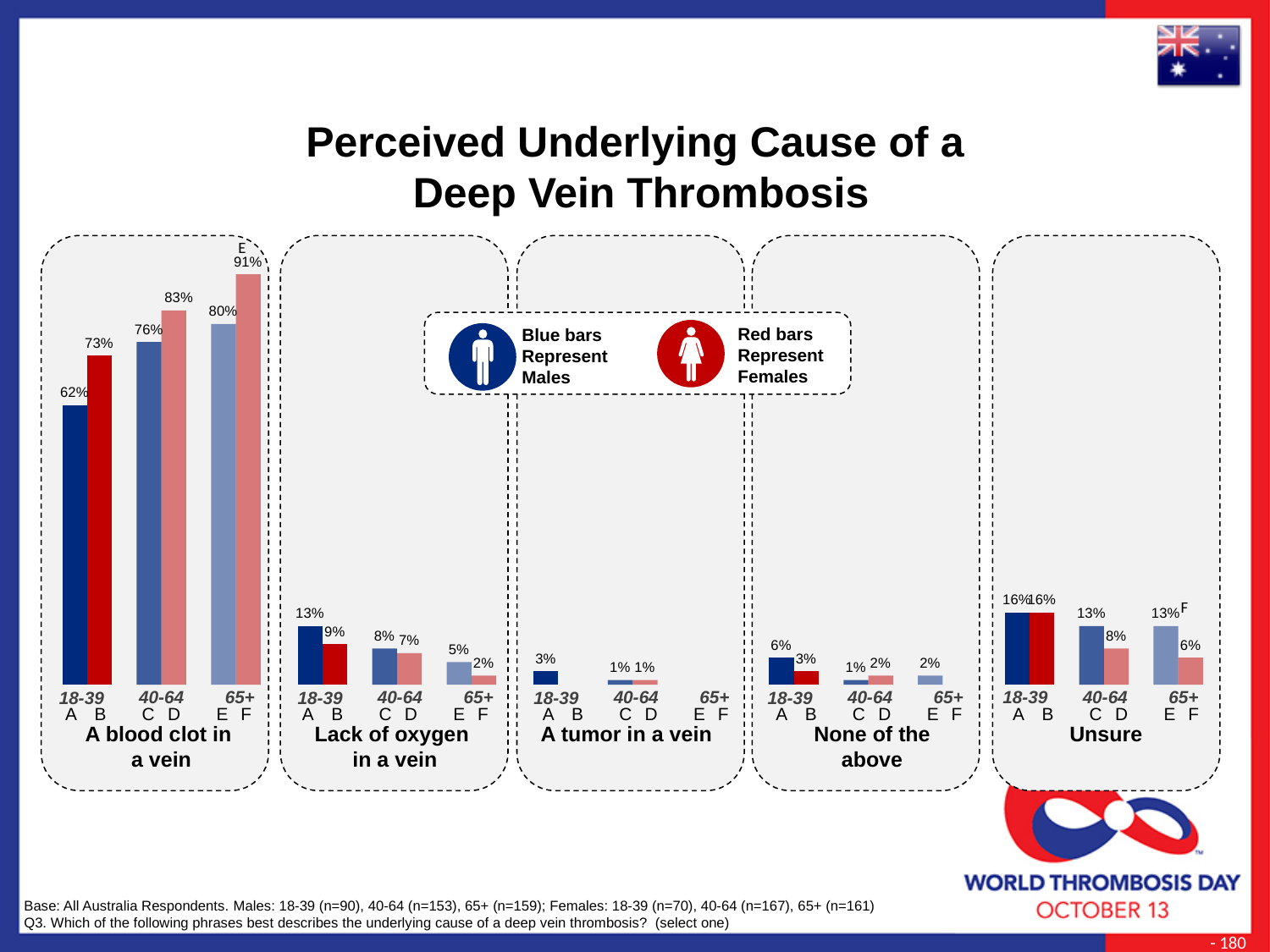
In the 'Lack of oxygen in a vein' panel, which age group has the highest male value? 18-39 In the 'A tumor in a vein' panel, what percentage of males aged 18-39 chose this cause? 3% In the 'A blood clot in a vein' panel, do the female values rise or fall as age group increases from 18-39 to 65+? Rise In the 'A blood clot in a vein' panel, what percentage of males aged 18-39 chose this cause? 62% In the 'A blood clot in a vein' panel, what is the difference between the female and male values for the 40-64 age group? 7% In the 'Unsure' panel, what percentage of females aged 40-64 were unsure? 8% In the 'Unsure' panel, what is the difference between the male and female values for the 65+ age group? 7% What type of chart is used on this slide? Bar chart According to the legend, what do the red bars represent? Females In the 'None of the above' panel, which is larger for the 18-39 age group, the male value or the female value? Male In the 'A blood clot in a vein' panel, what percentage of females aged 65+ chose this cause? 91% In the 'Lack of oxygen in a vein' panel, what percentage of females aged 65+ chose this cause? 2%